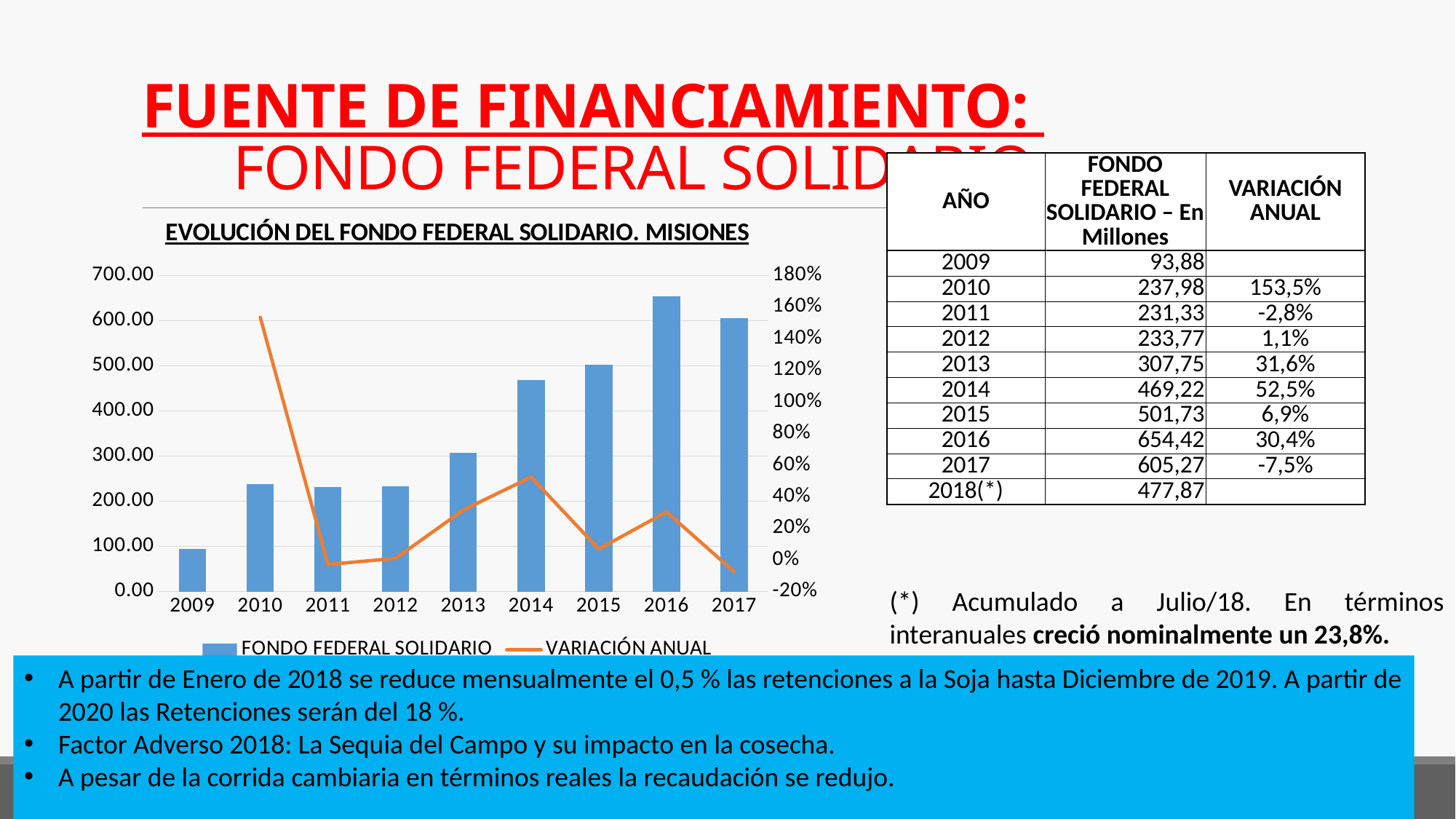
What colour is the VARIACIÓN ANUAL line in the chart? Orange Is the FONDO FEDERAL SOLIDARIO bar for 2014 greater or less than 500.00? less What type of chart is shown under the title 'EVOLUCIÓN DEL FONDO FEDERAL SOLIDARIO. MISIONES'? A bar chart combined with a line chart Is the FONDO FEDERAL SOLIDARIO bar for 2009 greater or less than 100.00? less How many years are shown on the x axis of the chart? 9 Which year has a taller FONDO FEDERAL SOLIDARIO bar, 2013 or 2014? 2014 In which year does the VARIACIÓN ANUAL line reach its highest point? 2010 Which year has the tallest FONDO FEDERAL SOLIDARIO bar? 2016 How many series does the chart legend list? 2 Which year has the shortest FONDO FEDERAL SOLIDARIO bar? 2009 Is the FONDO FEDERAL SOLIDARIO bar for 2016 greater or less than 600.00? greater Does the VARIACIÓN ANUAL line rise or fall between 2016 and 2017? Fall